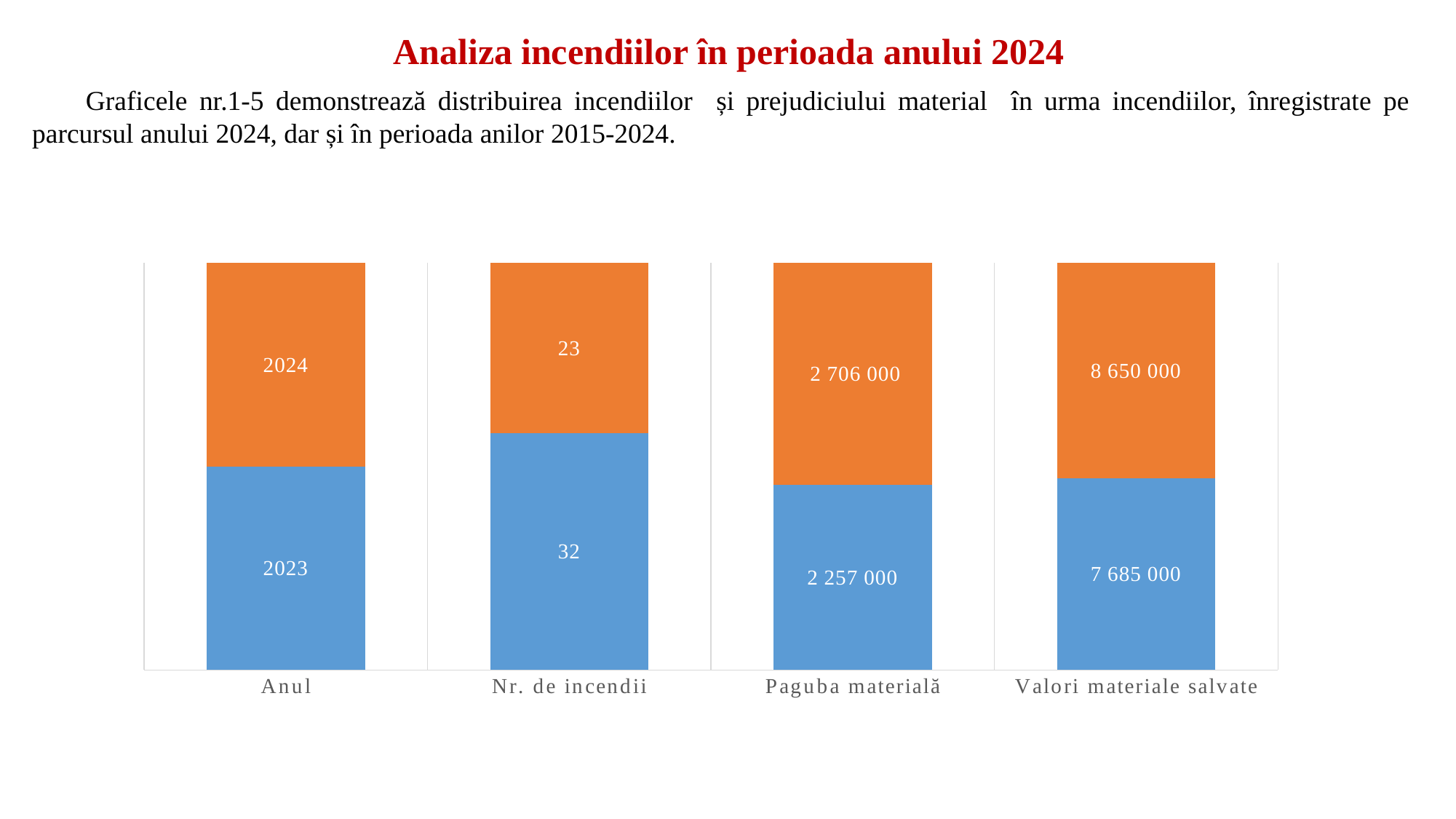
What is the value of Valori materiale salvate for 2024 (the orange segment)? 8 650 000 What is the difference between the Paguba materială values for 2024 and 2023? 449 000 By how much did the number of fires (Nr. de incendii) decrease from 2023 to 2024? 9 What is the number of fires (Nr. de incendii) shown for 2023 (the blue segment)? 32 What is the value of Paguba materială for 2024 (the orange segment)? 2 706 000 How many categories are shown on the x axis of the chart? 4 What is the number of fires (Nr. de incendii) shown for 2024 (the orange segment)? 23 What is the value of Valori materiale salvate for 2023 (the blue segment)? 7 685 000 Which year has the larger value for Valori materiale salvate, 2023 or 2024? 2024 What type of chart is shown on the slide? Stacked bar chart What is the combined number of fires (Nr. de incendii) for 2023 and 2024 in the stacked bar? 55 What is the value of Paguba materială for 2023 (the blue segment)? 2 257 000